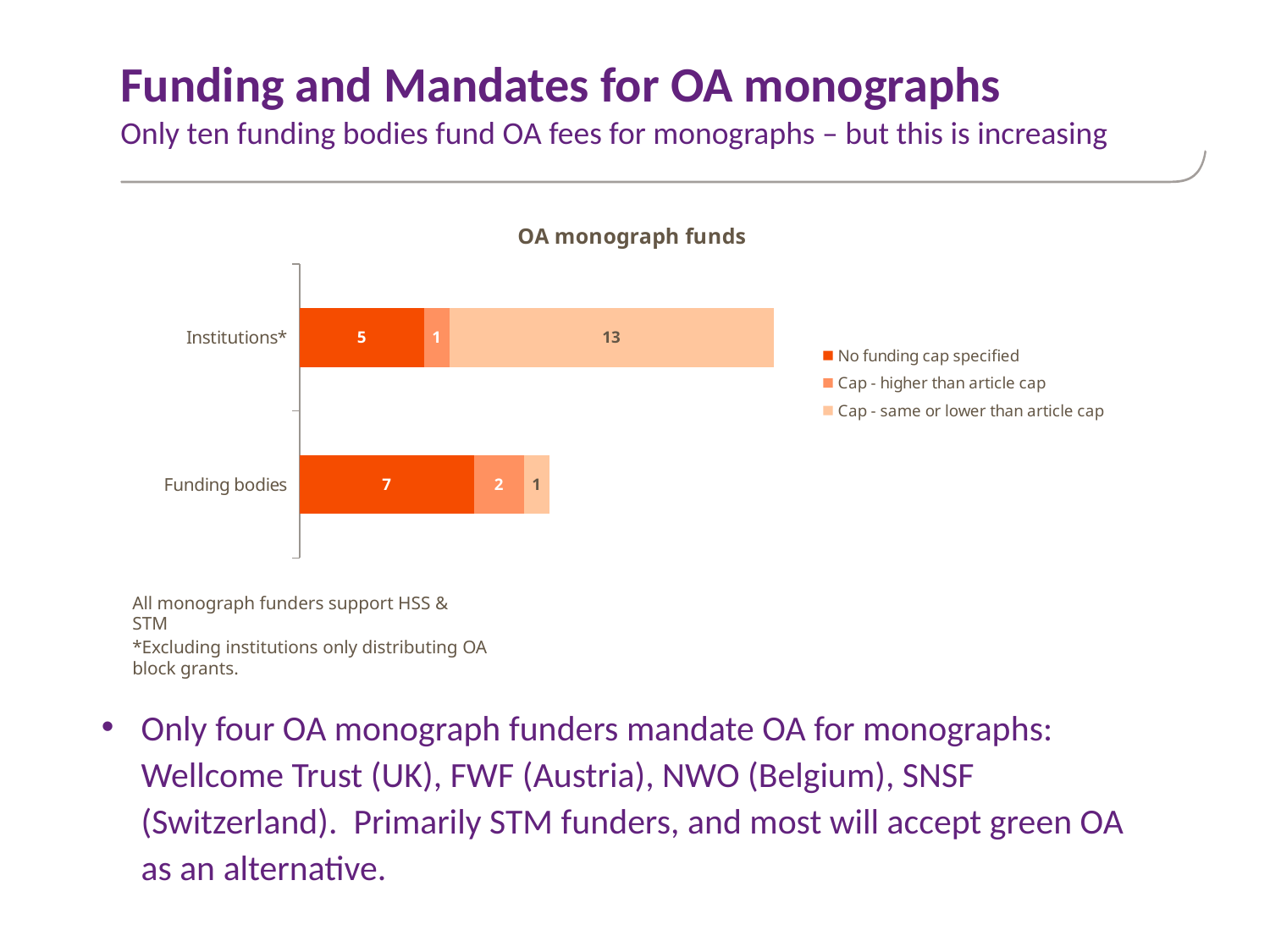
What is the value for 'No funding cap specified' for Funding bodies? 7 What is the total of the stacked bar for Institutions*? 19 What is the difference between the 'No funding cap specified' values for Funding bodies and Institutions*? 2 What is the title of the chart? OA monograph funds How many series does the legend list? 3 What is the value for 'Cap - higher than article cap' for Funding bodies? 2 What is the value for 'No funding cap specified' for Institutions*? 5 What type of chart is shown on the slide? Stacked bar chart Which category has the larger 'Cap - same or lower than article cap' value, Institutions* or Funding bodies? Institutions* What is the total of the stacked bar for Funding bodies? 10 What is the value for 'Cap - same or lower than article cap' for Institutions*? 13 How many categories are shown on the chart? 2